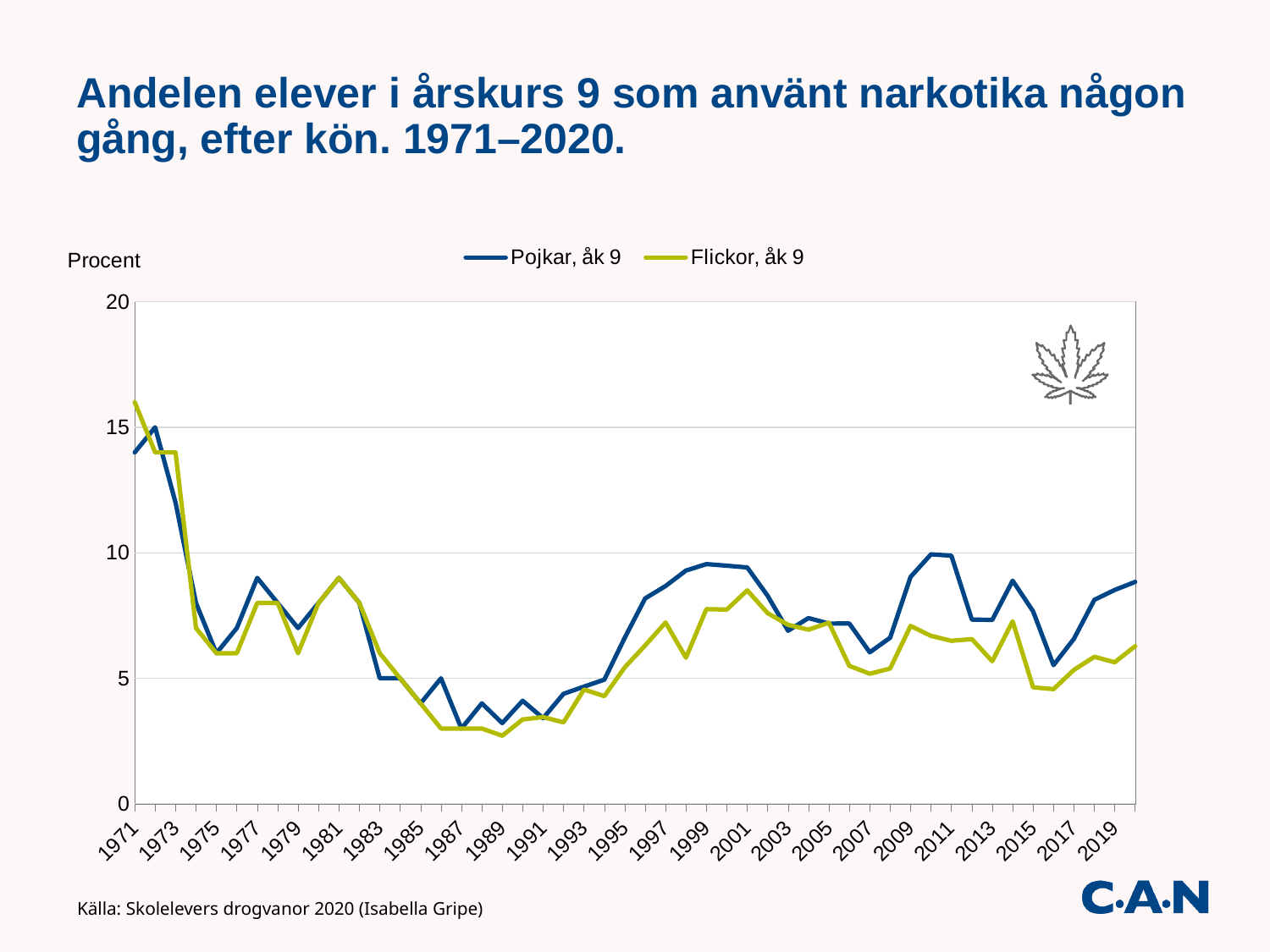
Is the value for Pojkar, åk 9 in 1971 greater or less than 10? greater Is the value for Flickor, åk 9 in 1971 greater or less than 15? greater In 2011, which series has the higher value, Pojkar, åk 9 or Flickor, åk 9? Pojkar, åk 9 What is the label on the vertical axis? Procent Is the value for Pojkar, åk 9 in 2020 greater or less than 10? less Does the value for Pojkar, åk 9 rise or fall between 1971 and 1975? fall Does the value for Pojkar, åk 9 rise or fall between 1989 and 1999? rise What are the two series named in the legend? Pojkar, åk 9 and Flickor, åk 9 In 1971, which series has the higher value, Pojkar, åk 9 or Flickor, åk 9? Flickor, åk 9 How many series does the legend list? 2 What kind of chart is shown on the slide? line chart